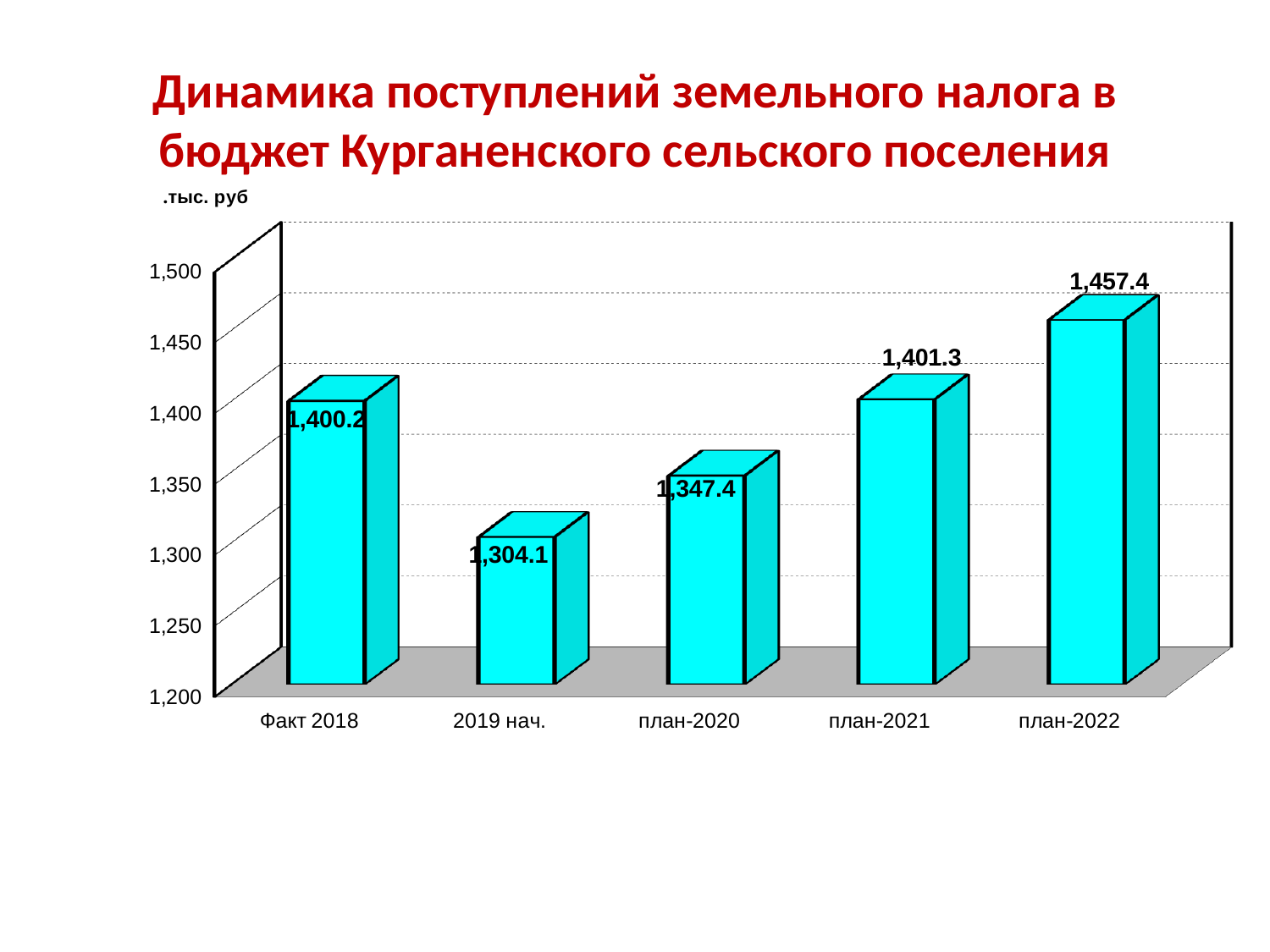
Which category has the lowest value? 2019 нач. Is the value for 2019 нач. greater or less than 1,350? less Which category has the highest value? план-2022 How many categories are shown on the x axis? 5 What is the value for 2019 нач.? 1,304.1 What is the value for план-2022? 1,457.4 What is the value for план-2020? 1,347.4 What kind of chart is shown on the slide? bar chart What is the difference between the values for план-2022 and план-2021? 56.1 Which is larger, the value for план-2020 or the value for 2019 нач.? план-2020 From 2019 нач. to план-2022, do the values rise or fall? rise What is the difference between the values for Факт 2018 and 2019 нач.? 96.1